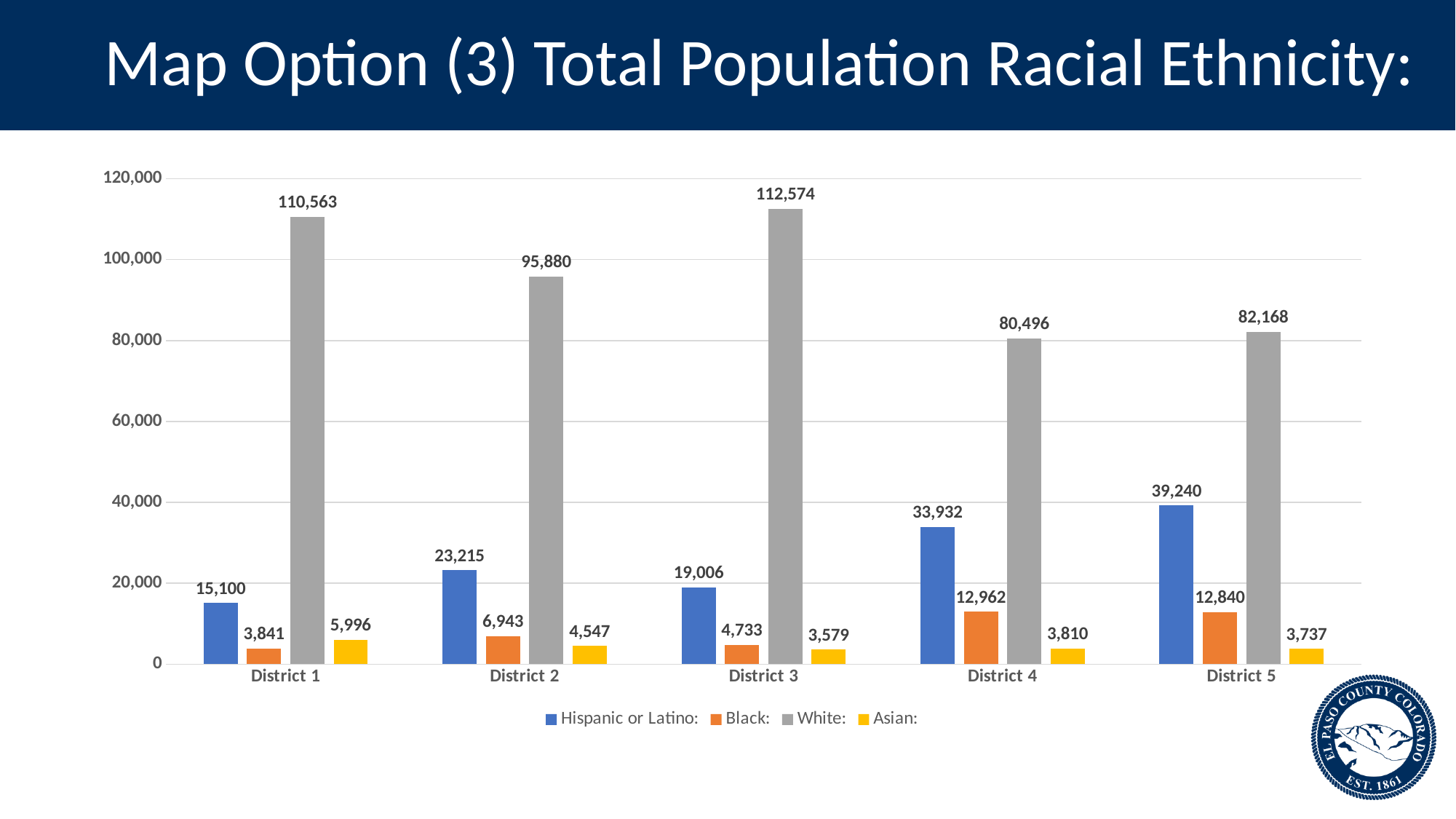
What kind of chart is shown on the slide? bar chart What is the Hispanic or Latino population in District 5? 39,240 Which district has the lowest Hispanic or Latino population? District 1 Which is larger, the Black population in District 4 or in District 5? District 4 Is the Hispanic or Latino value for District 4 greater or less than 40,000? less What is the White population in District 3? 112,574 Which district has the highest White population? District 3 What is the Asian population in District 4? 3,810 How many districts are shown on the x axis? 5 How many series does the legend list? 4 What is the Black population in District 2? 6,943 What is the difference between the White population in District 1 and District 2? 14,683